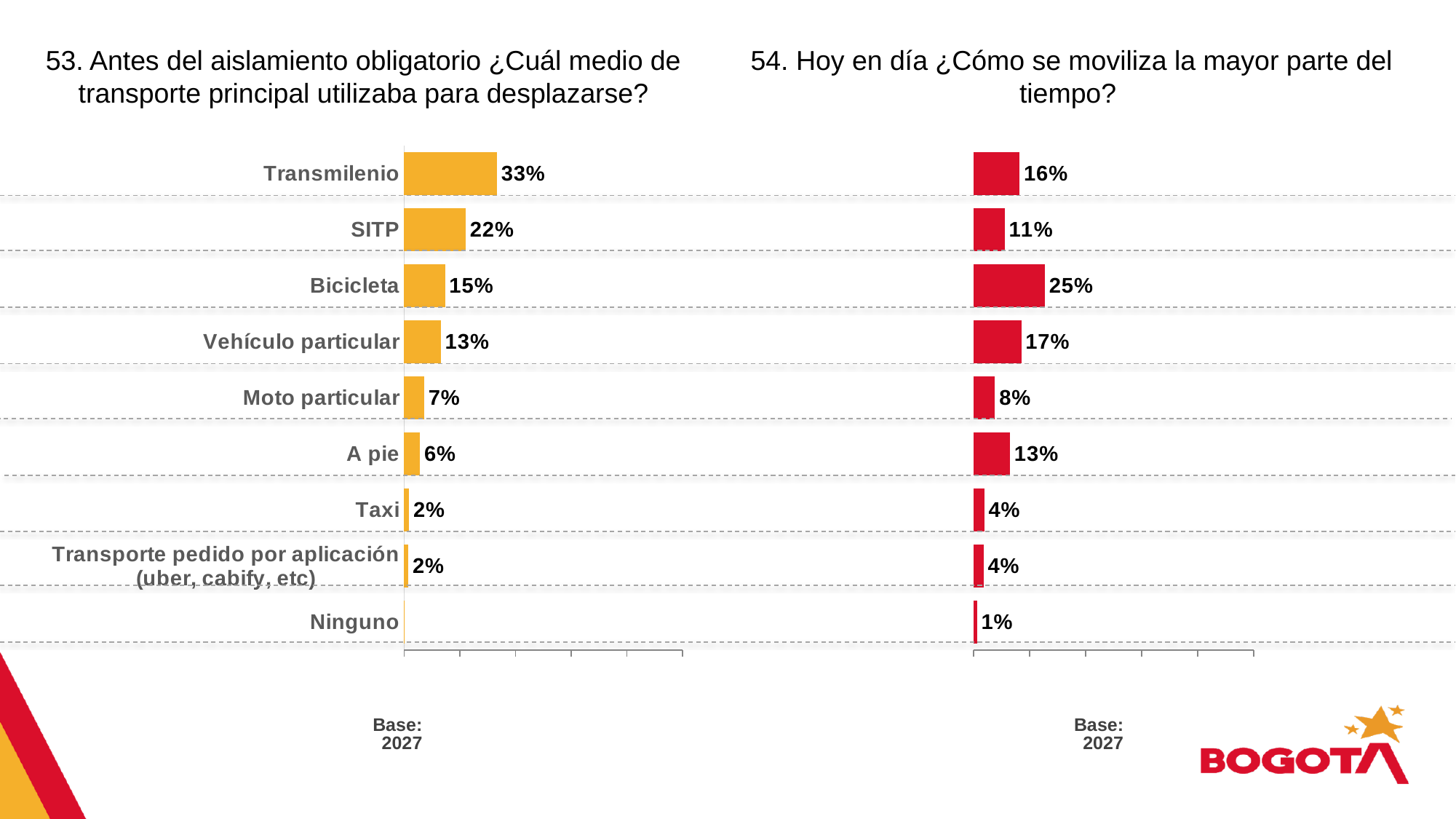
How many categories are listed on the left chart (question 53)? 9 In the right chart (question 54, today), what percentage is shown for Bicicleta? 25% In the right chart (question 54, today), which category has the highest value? Bicicleta In the right chart (question 54, today), what percentage is shown for Ninguno? 1% In the right chart (question 54, today), which category has the lowest value? Ninguno In the left chart (question 53, before mandatory isolation), what percentage is shown for Transmilenio? 33% What type of chart is used for question 54 on the right? Bar chart Which is larger: Vehículo particular in the left chart or Vehículo particular in the right chart? Right chart (17%) In the left chart (question 53), what is the difference between SITP and Bicicleta? 7% What colour are the bars in the left chart (question 53)? Yellow/orange What is the difference between the Transmilenio value in the left chart (33%) and the Transmilenio value in the right chart (16%)? 17% In the left chart (question 53, before mandatory isolation), which category has the highest value? Transmilenio